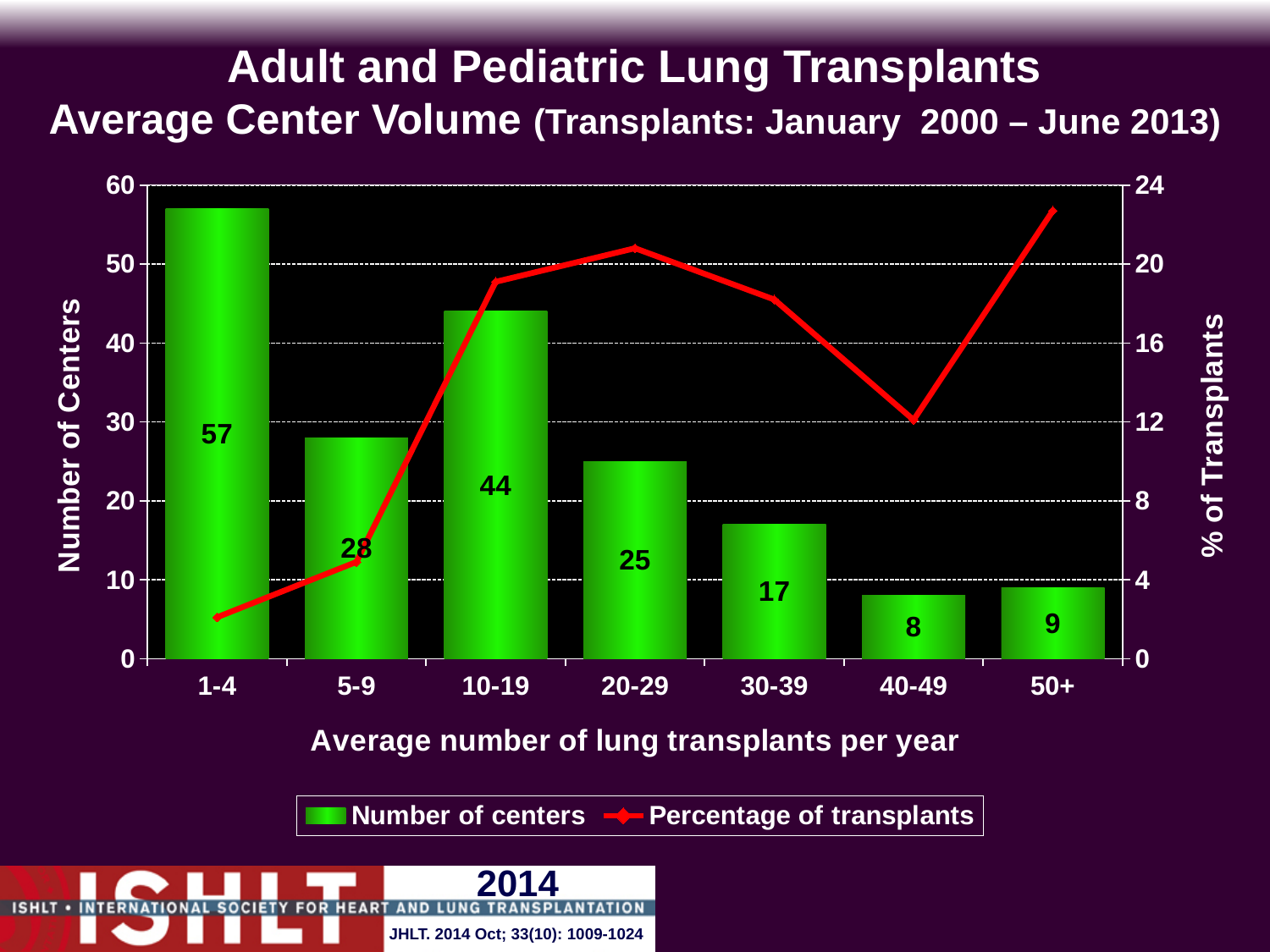
What is the number of centers for the 1-4 category? 57 Which category has the highest number of centers? 1-4 Is the percentage of transplants for the 10-19 category greater or less than 16? greater Which has more centers, the 5-9 category or the 20-29 category? 5-9 What is the label of the right-hand vertical axis? % of Transplants How many series does the legend list? 2 How many categories are shown on the x axis? 7 What is the difference in number of centers between the 1-4 and 10-19 categories? 13 Is the percentage of transplants for the 50+ category greater or less than 20? greater Which category has the lowest number of centers? 40-49 What is the number of centers for the 30-39 category? 17 Is the percentage of transplants for the 1-4 category greater or less than 4? less